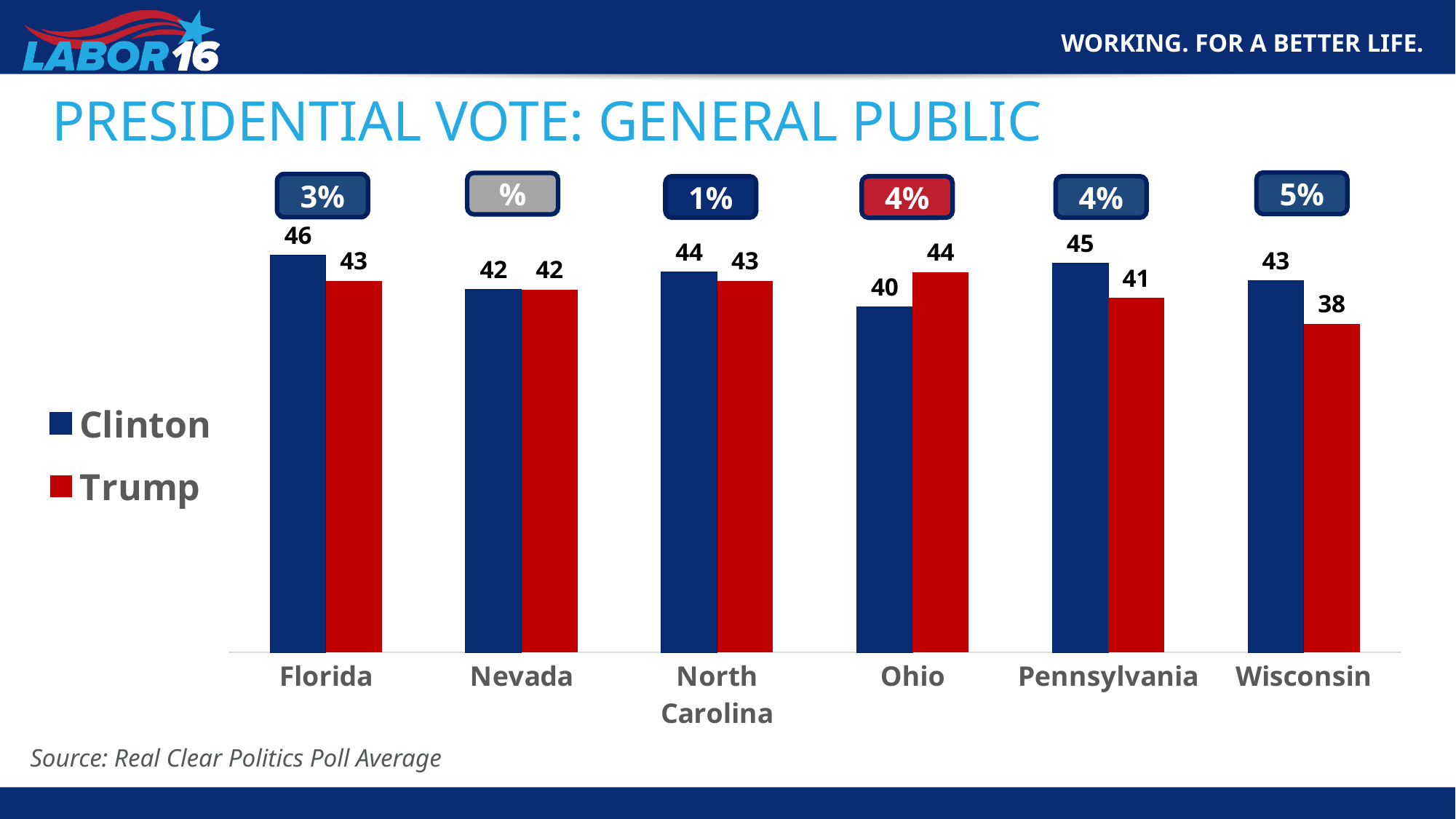
What is the title of the chart? PRESIDENTIAL VOTE: GENERAL PUBLIC What is the difference between Clinton's and Trump's values in Pennsylvania? 4 In which state is Clinton's value highest? Florida What is Trump's value for Ohio? 44 In which state is Trump's value lowest? Wisconsin Which is larger in North Carolina, Clinton's value or Trump's value? Clinton's value How many states are shown on the x axis? 6 What is Clinton's value for Florida? 46 What is the difference between Trump's and Clinton's values in Ohio? 4 What kind of chart is shown on the slide? Bar chart How many series does the legend list? 2 What is Trump's value for Wisconsin? 38